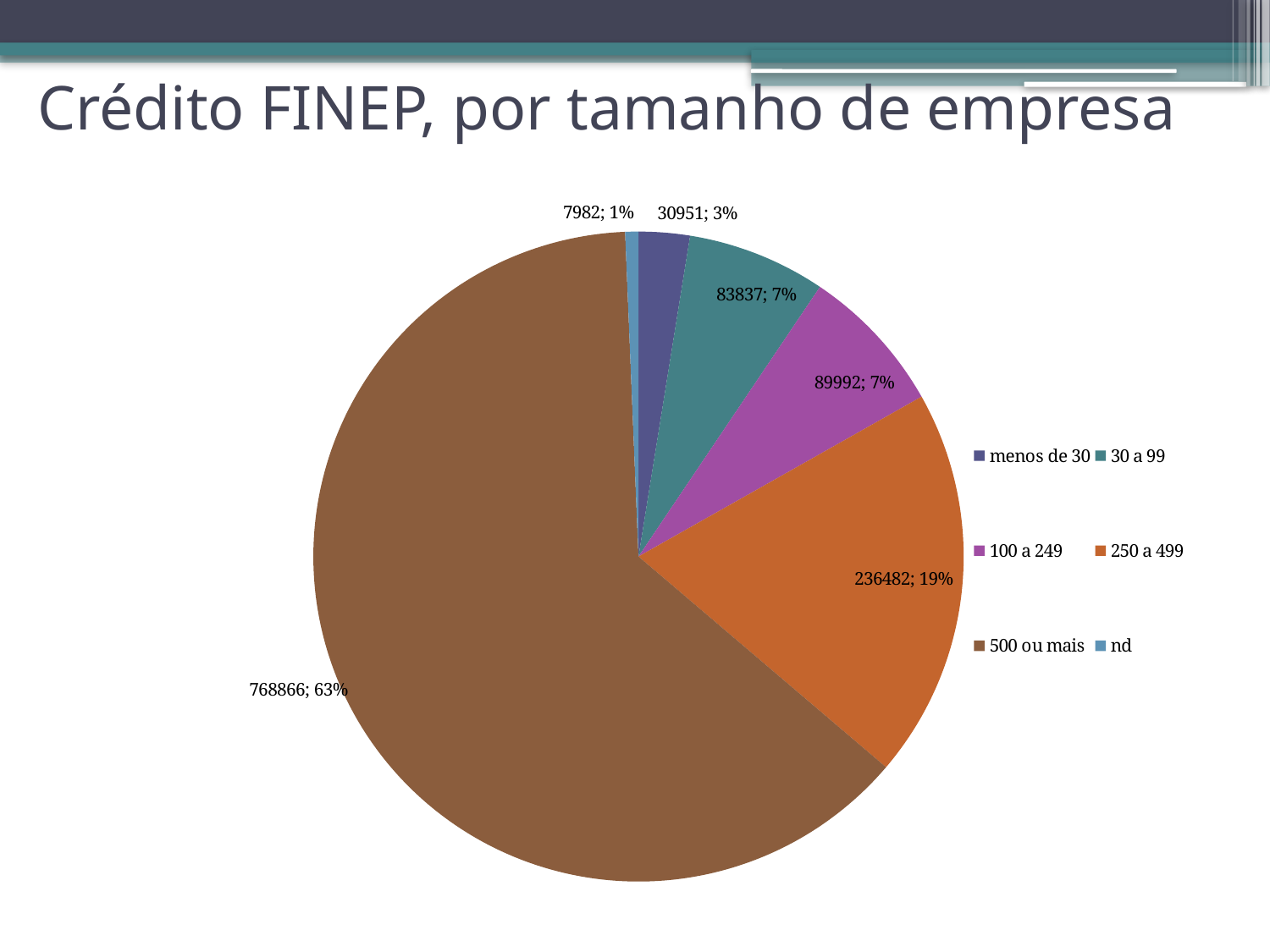
What share of the pie does the '500 ou mais' slice represent? 63% Which category has the largest slice? 500 ou mais What is the value for the '30 a 99' slice? 83837 Which category has the smallest slice? nd What is the value for the 'nd' slice? 7982 How many slices does the pie chart have? 6 What is the value for the '500 ou mais' slice? 768866 What is the title of the slide? Crédito FINEP, por tamanho de empresa What share of the pie does the '250 a 499' slice represent? 19% What kind of chart is shown on the slide? pie chart What is the value for the '250 a 499' slice? 236482 What is the difference between the values for '250 a 499' and '100 a 249'? 146490